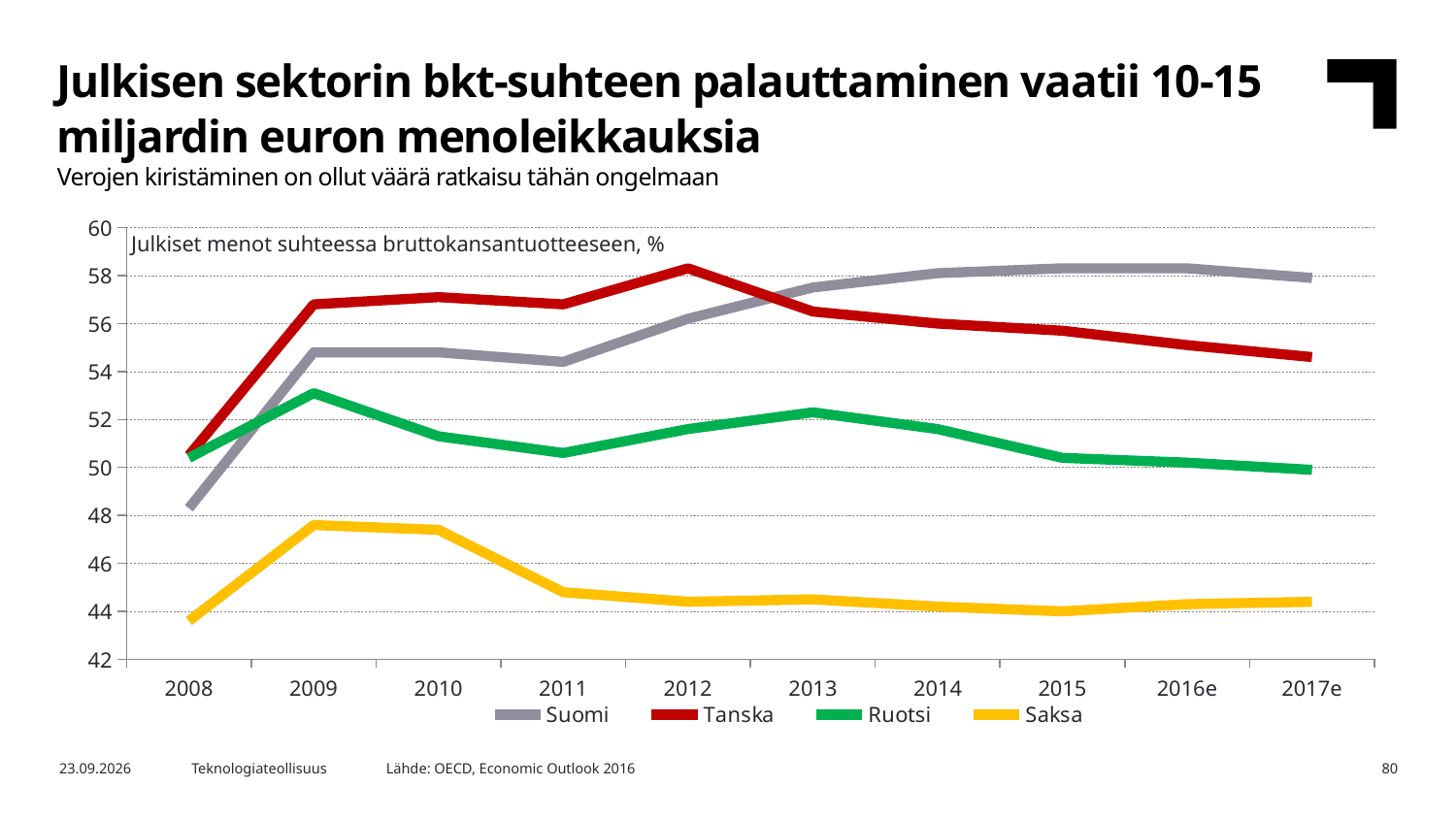
Is the value for Saksa in 2008 greater or less than 44? less How many years are shown on the x axis? 10 How many series does the legend list? 4 Which country has the lowest values across the whole period? Saksa Which country has the highest value in 2017e? Suomi Is the value for Suomi in 2008 greater or less than 50? less What label is printed inside the chart area describing what is plotted? Julkiset menot suhteessa bruttokansantuotteeseen, % Does the value for Suomi rise or fall from 2008 to 2015? rise Does the value for Saksa rise or fall from 2009 to 2011? fall Which country has the highest value in 2012? Tanska Which is larger in 2009, the value for Suomi or the value for Tanska? Tanska What kind of chart is shown on the slide? line chart